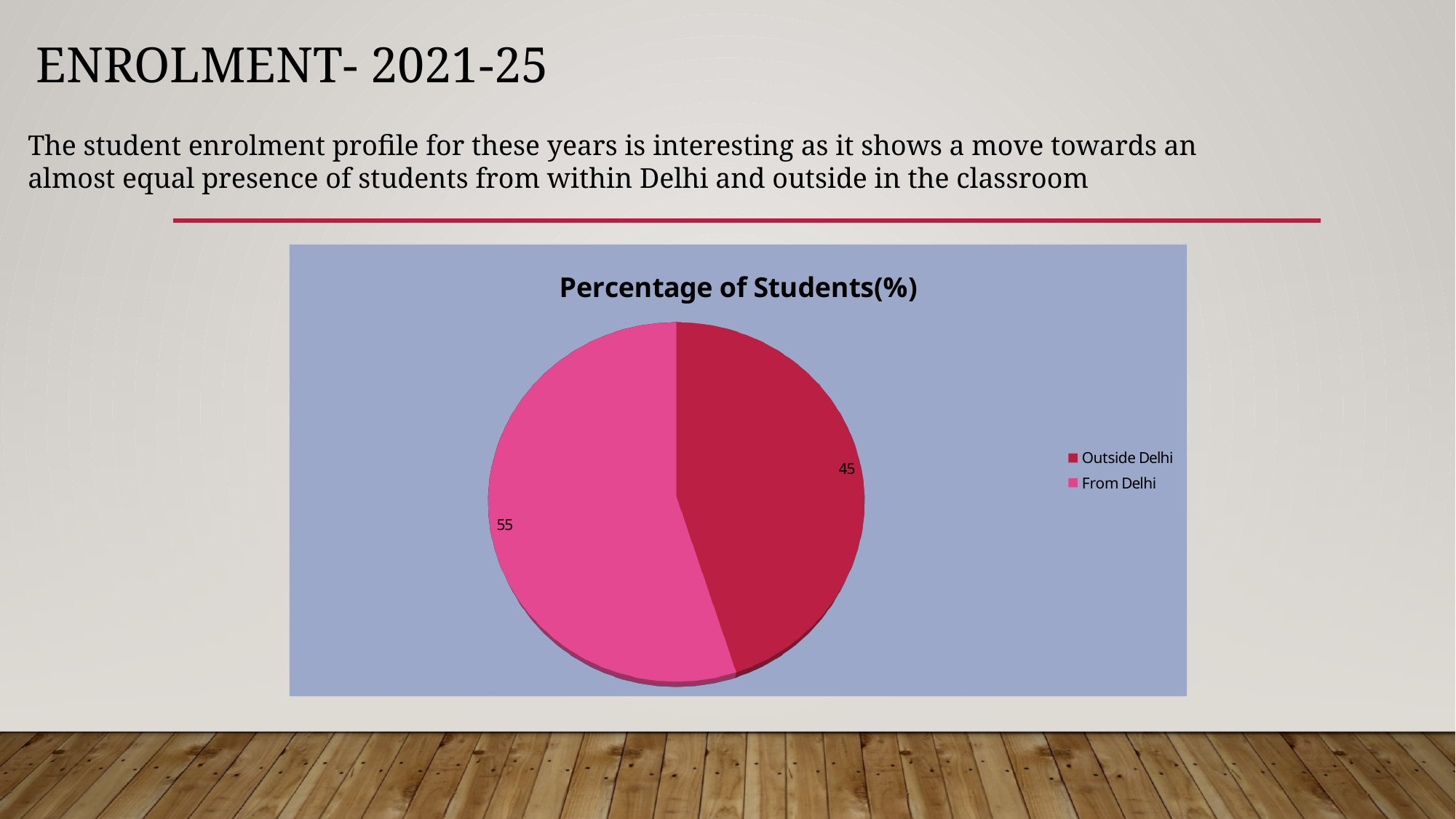
What kind of chart is shown on the slide? Pie chart Which is larger, the value for Outside Delhi or the value for From Delhi? From Delhi Which legend entry is shown in the darker red colour? Outside Delhi How many entries does the legend list? 2 Which category has the smallest slice of the pie? Outside Delhi What is the value for Outside Delhi? 45 What is the value for From Delhi? 55 What is the difference between the values for From Delhi and Outside Delhi? 10 How many slices does the pie chart have? 2 What share of the pie does the From Delhi slice represent? 55% What is the title of the chart? Percentage of Students(%) Which category has the largest slice of the pie? From Delhi